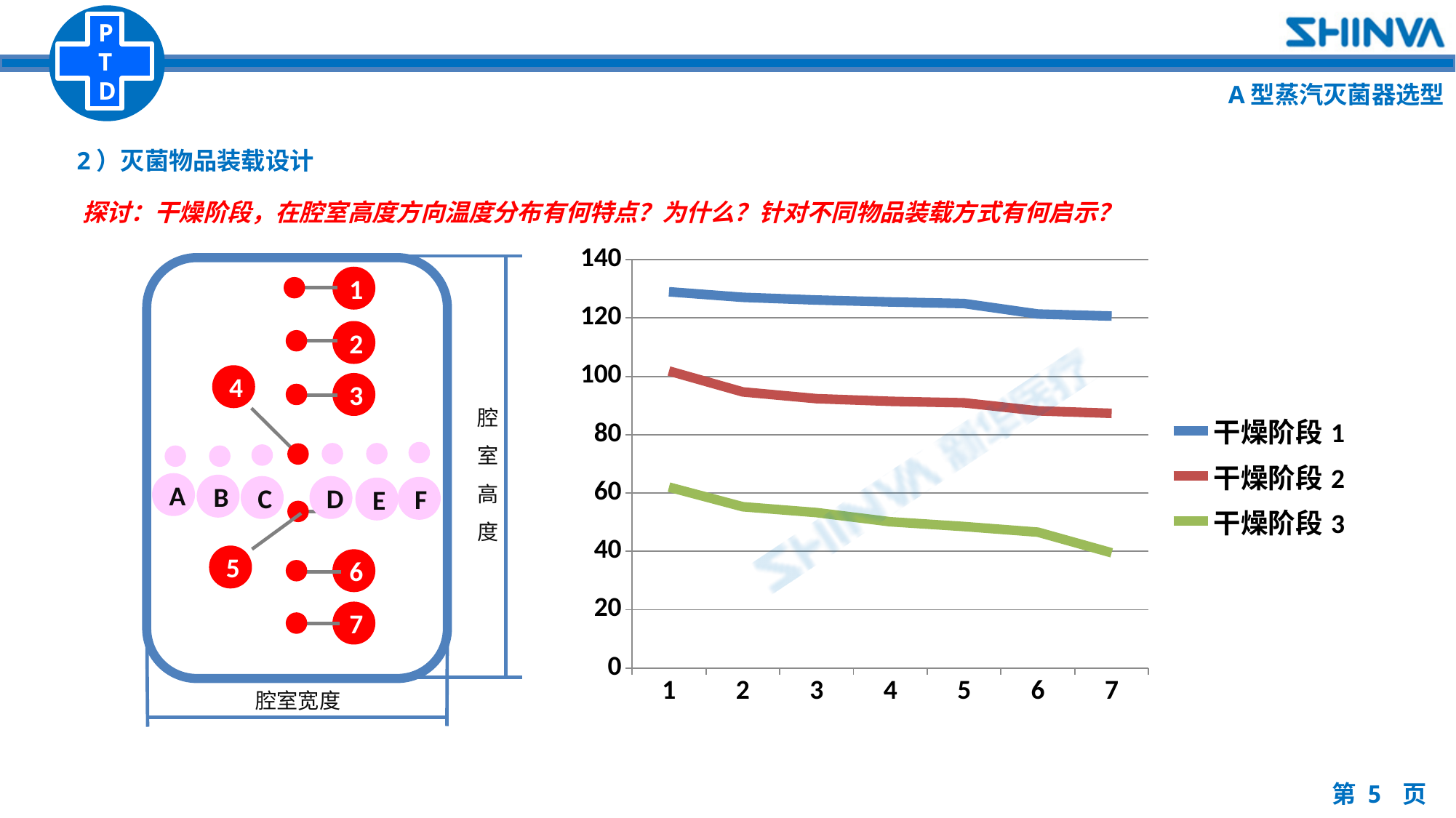
What colour is the line for 干燥阶段 2? red Is the value for 干燥阶段 2 at point 7 greater or less than 100? less Is the value for 干燥阶段 3 at point 7 greater or less than 60? less How many points are plotted along the x axis for each series? 7 Which series has the highest values across the chart? 干燥阶段 1 How many series does the chart legend list? 3 Is the value for 干燥阶段 3 at point 7 greater or less than 20? greater At point 4, which is larger: the value for 干燥阶段 1 or the value for 干燥阶段 3? 干燥阶段 1 Do the values of 干燥阶段 3 rise or fall from point 1 to point 7? fall Which series has the lowest values across the chart? 干燥阶段 3 What kind of chart is shown on the slide? line chart